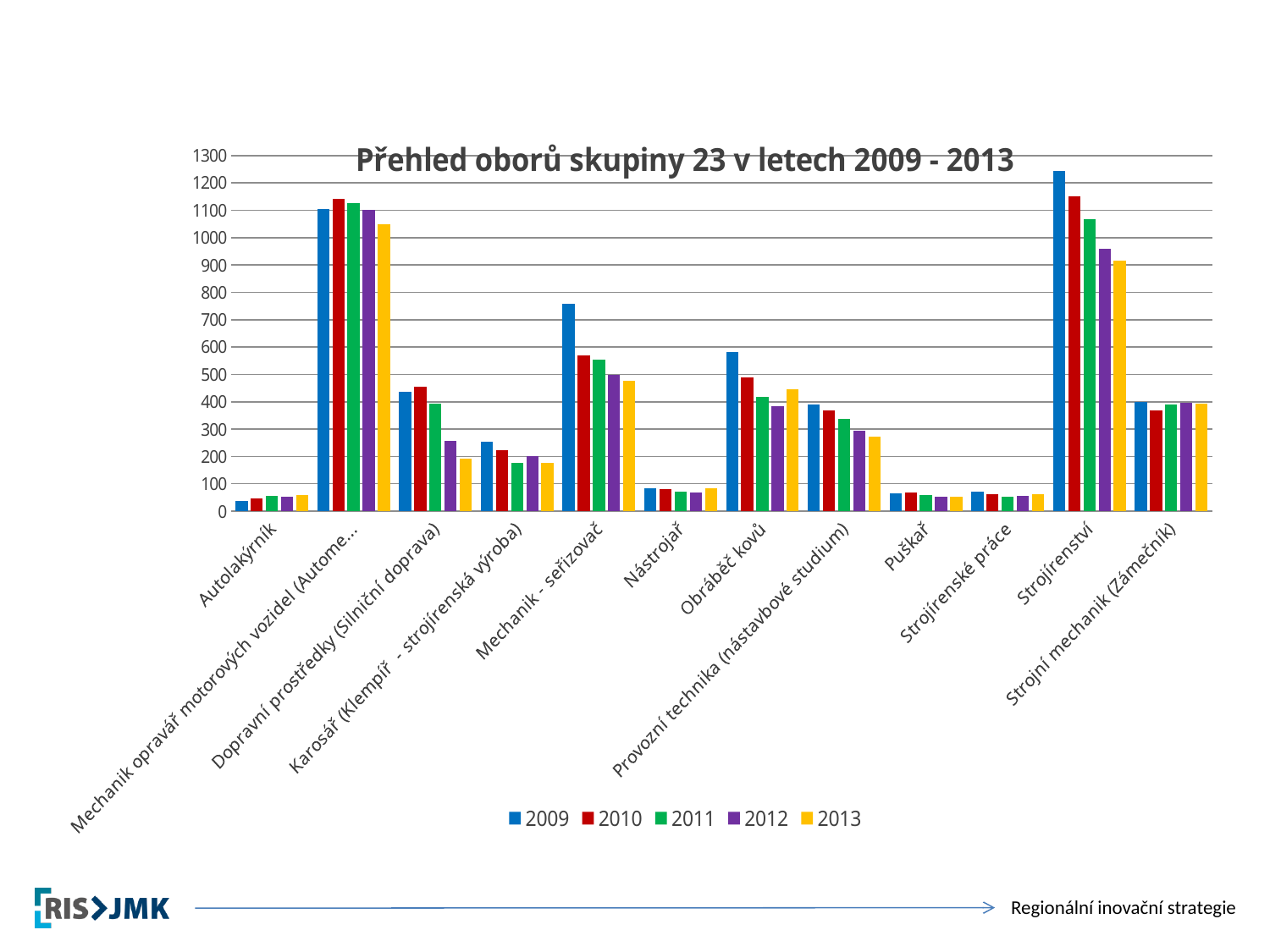
Is the 2013 value for Strojírenství greater or less than 800? greater What is the title of the chart? Přehled oborů skupiny 23 v letech 2009 - 2013 Which category has the lowest bars in the chart? Autolakýrník Is the 2013 value for Dopravní prostředky (Silniční doprava) greater or less than 300? less How many series does the legend list? 5 Do the values for Strojírenství rise or fall from 2009 to 2013? fall What kind of chart is shown on the slide? bar chart Which is larger for 2009: Obráběč kovů or Mechanik - seřizovač? Mechanik - seřizovač How many categories are shown on the x axis? 12 Which category has the highest bar in the chart? Strojírenství Is the 2009 value for Nástrojař greater or less than 100? less